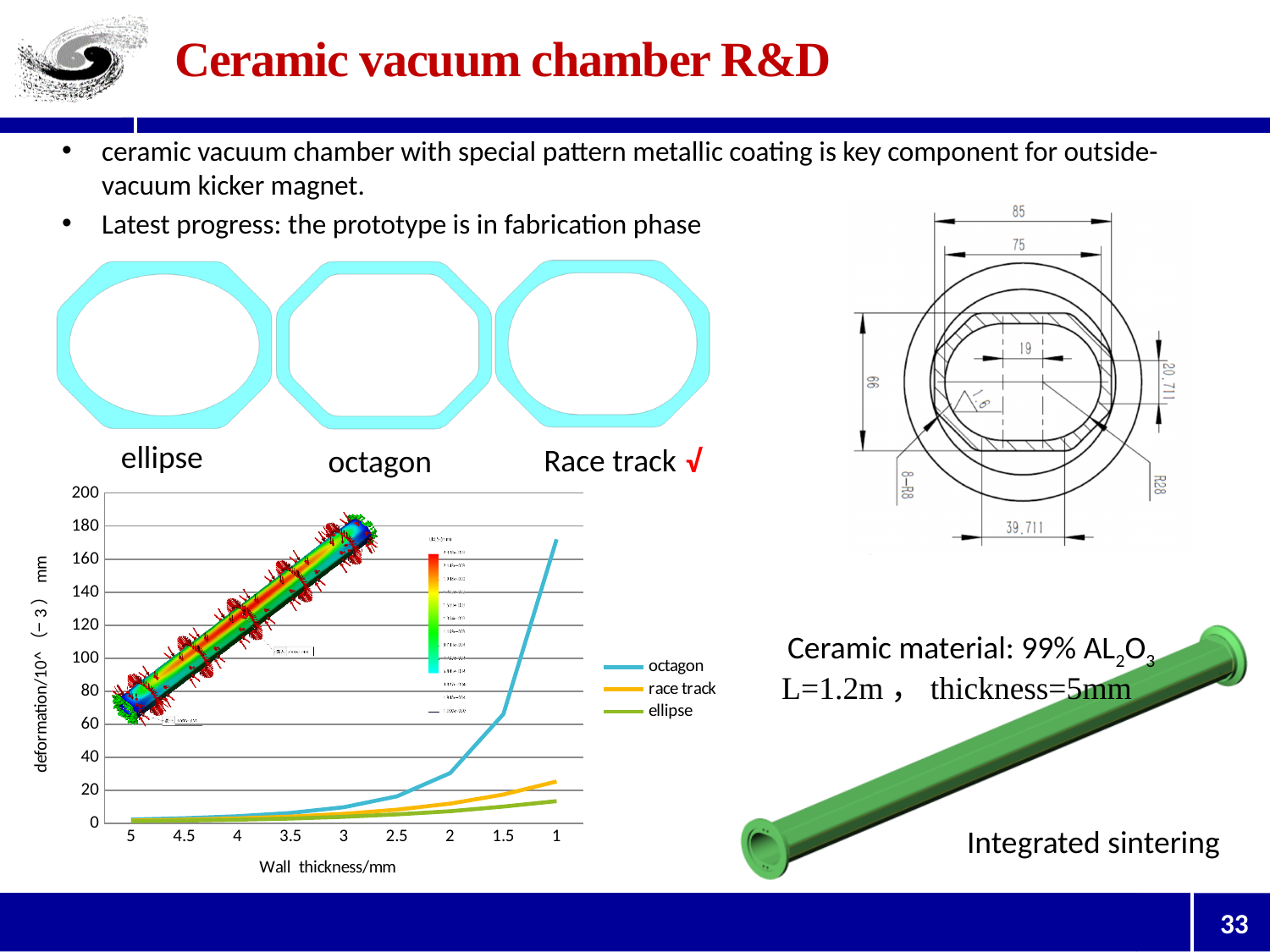
What kind of chart is shown on the slide? line chart Do the deformation values for octagon rise or fall as you move from left to right along the x axis? rise Is the deformation for octagon at a wall thickness of 1 mm greater or less than 160? greater How many wall thickness values are marked on the x axis of the chart? 9 Is the deformation for octagon at a wall thickness of 2 mm greater or less than 40? less Which series has the highest deformation at a wall thickness of 1 mm? octagon Which series has the lowest deformation at a wall thickness of 1 mm? ellipse At a wall thickness of 1 mm, which series has the larger deformation, race track or ellipse? race track What is the label of the x axis of the chart? Wall thickness/mm Is the deformation for octagon at a wall thickness of 1.5 mm greater or less than 60? greater How many series does the chart legend list? 3